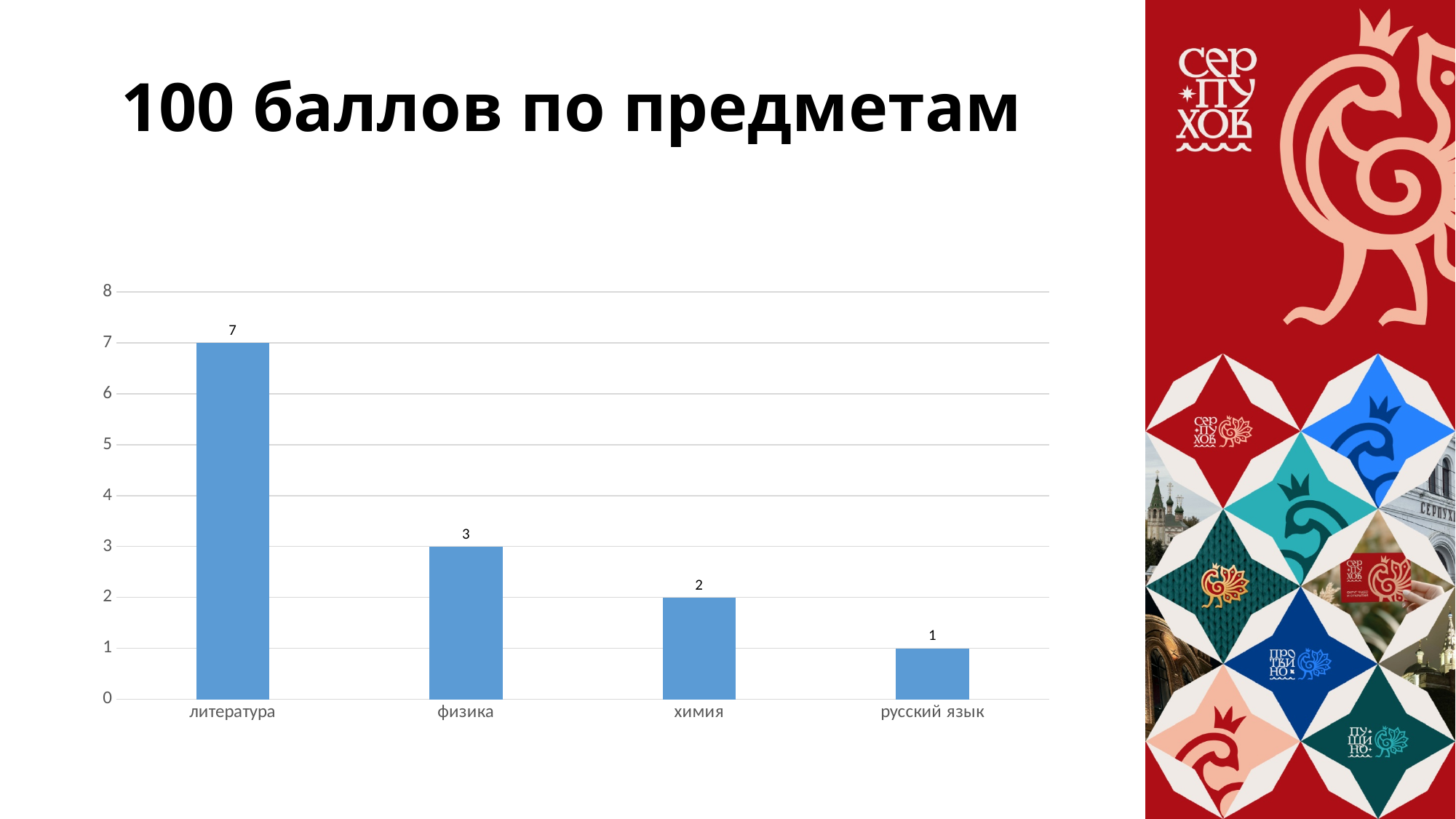
Is the value for литература greater or less than 5? greater Which category has the lowest value? русский язык What is the value for физика? 3 What kind of chart is shown on the slide? bar chart Which is larger, the value for химия or the value for русский язык? химия How many categories are shown on the chart? 4 What is the value for русский язык? 1 What is the title of the slide? 100 баллов по предметам What is the difference between the values for литература and физика? 4 What is the value for химия? 2 Which category has the highest value? литература What is the value for литература? 7